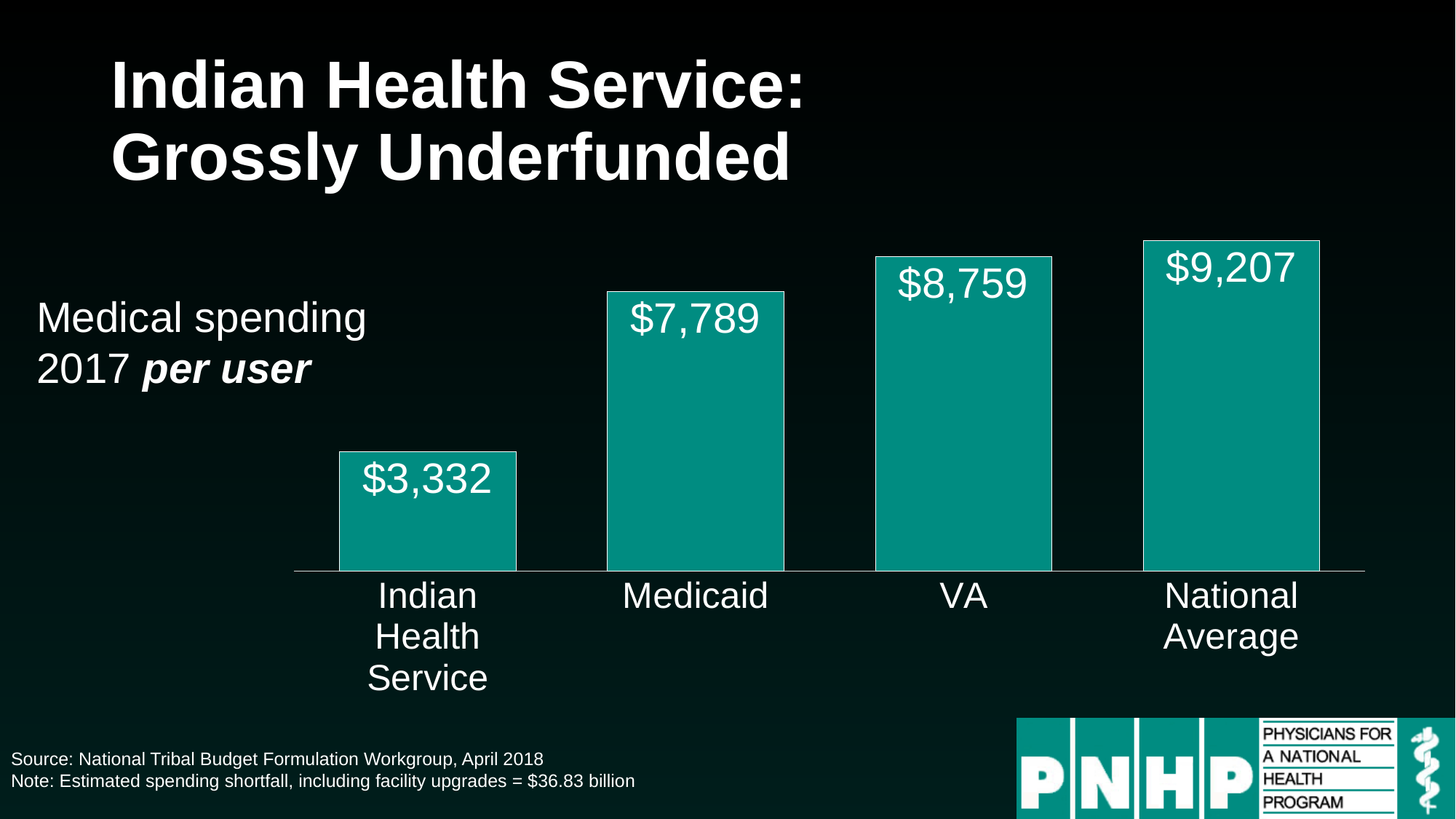
Which is larger, the spending per user for Medicaid or for the VA? VA Do the values rise or fall from left to right across the categories? Rise Which category has the highest medical spending per user? National Average What is the difference between VA and Medicaid spending per user? $970 What is the difference between the National Average and the Indian Health Service spending per user? $5,875 How many categories are shown in the chart? 4 What is the medical spending per user for the VA? $8,759 What is the National Average medical spending per user? $9,207 Which category has the lowest medical spending per user? Indian Health Service What kind of chart is shown on the slide? Bar chart What is the medical spending per user for the Indian Health Service? $3,332 What is the medical spending per user for Medicaid? $7,789